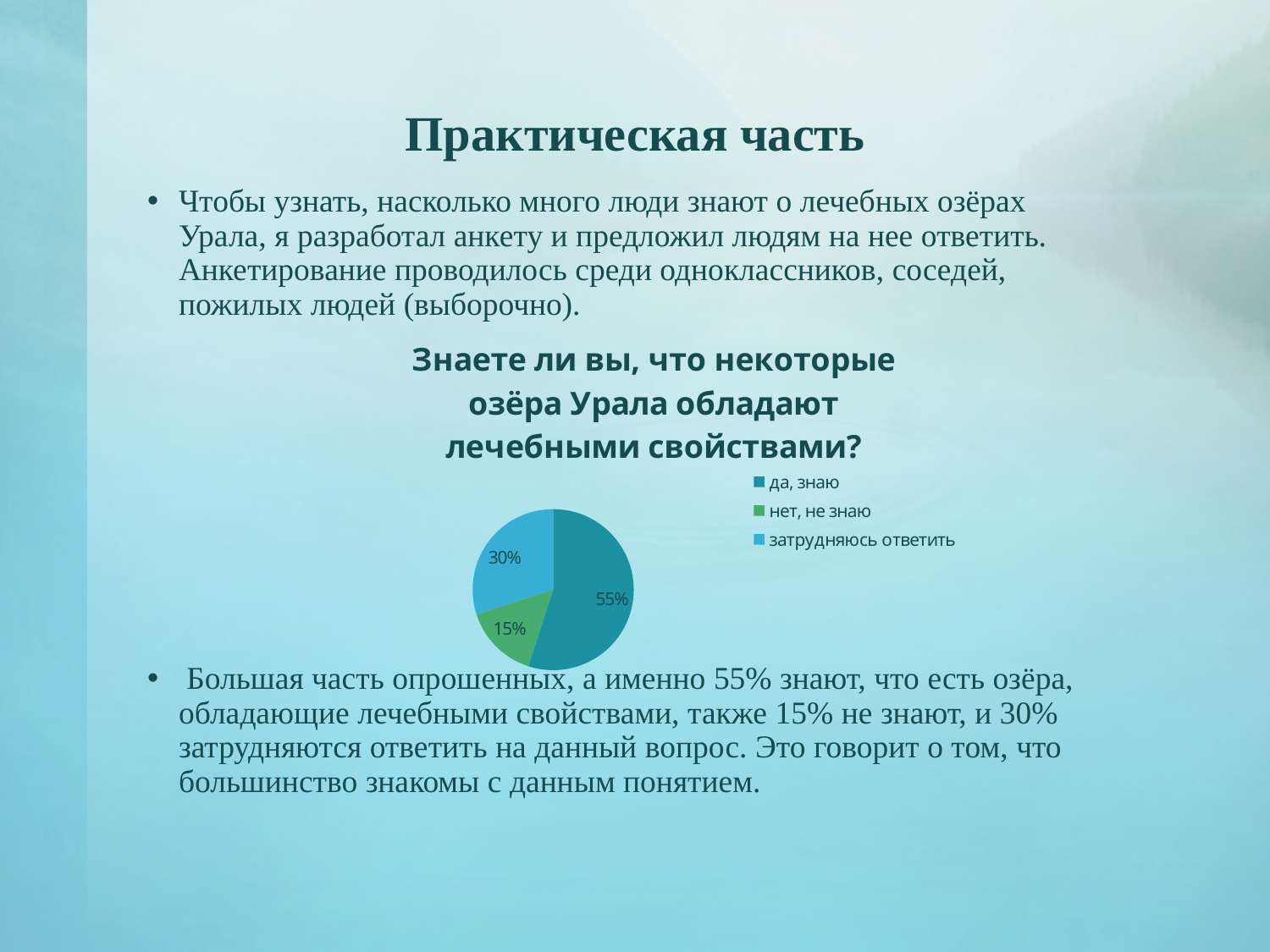
Which is larger: the share for "затрудняюсь ответить" or the share for "нет, не знаю"? затрудняюсь ответить What share of respondents answered "затрудняюсь ответить"? 30% What kind of chart is shown on the slide? pie chart What share of respondents answered "нет, не знаю"? 15% How many slices does the pie chart have? 3 Which answer has the smallest share of the pie? нет, не знаю Which answer has the largest share of the pie? да, знаю What is the title of the pie chart? Знаете ли вы, что некоторые озёра Урала обладают лечебными свойствами? What is the difference between the shares for "да, знаю" and "затрудняюсь ответить"? 25% What is the difference between the shares for "затрудняюсь ответить" and "нет, не знаю"? 15% How many entries does the legend list? 3 What share of respondents answered "да, знаю"? 55%